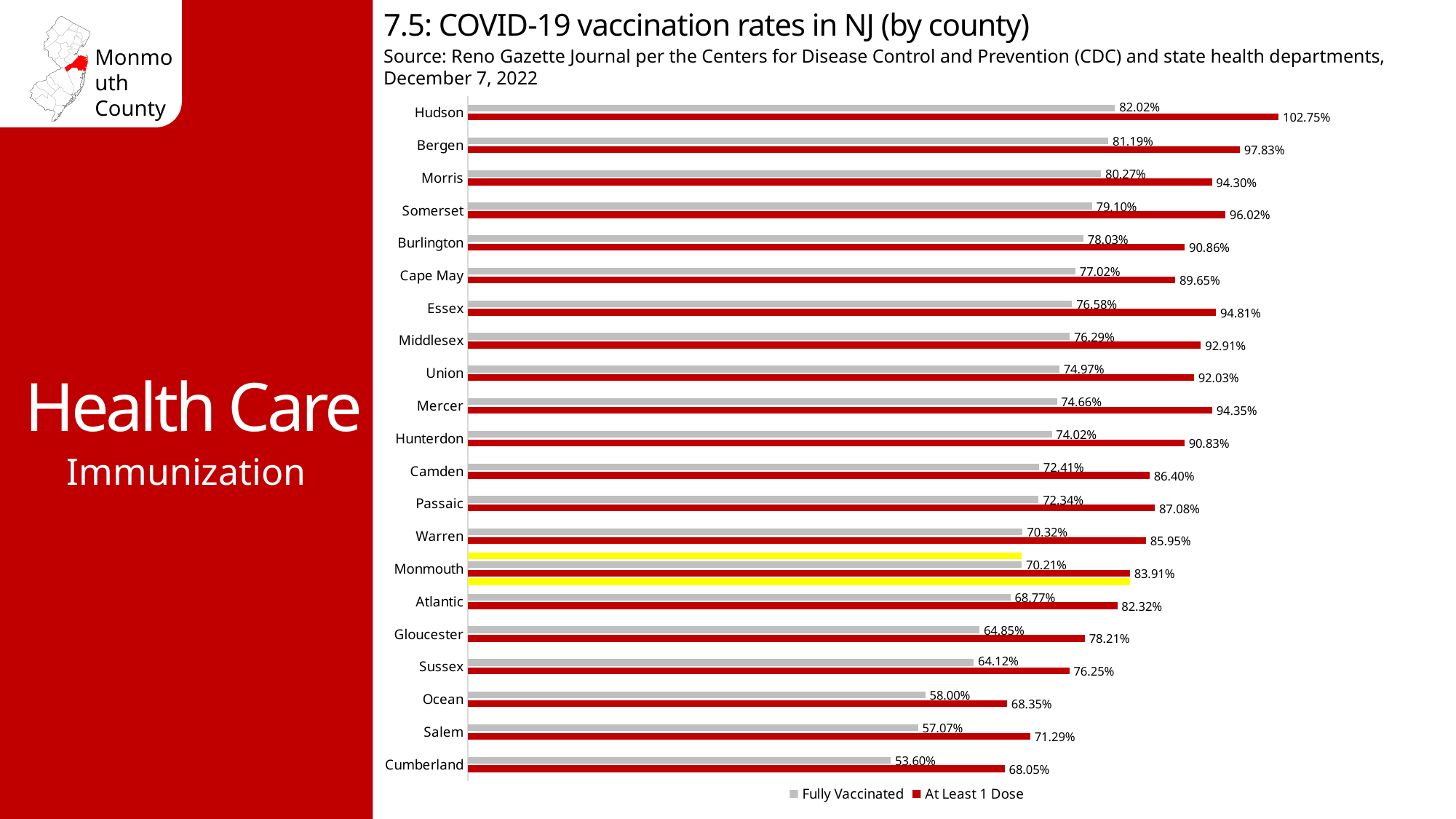
Which is larger, the At Least 1 Dose rate for Ocean or for Salem? Salem Which county's bars are highlighted in yellow? Monmouth Which county has the highest Fully Vaccinated rate? Hudson How many series does the legend list? 2 What is the Fully Vaccinated rate for Monmouth? 70.21% What is the At Least 1 Dose rate for Cumberland? 68.05% How many counties are shown in the chart? 21 What is the difference between the At Least 1 Dose rate and the Fully Vaccinated rate for Monmouth? 13.70% What is the At Least 1 Dose rate for Hudson? 102.75% Which county has the lowest At Least 1 Dose rate? Cumberland What kind of chart is shown on the slide? Bar chart What is the Fully Vaccinated rate for Sussex? 64.12%